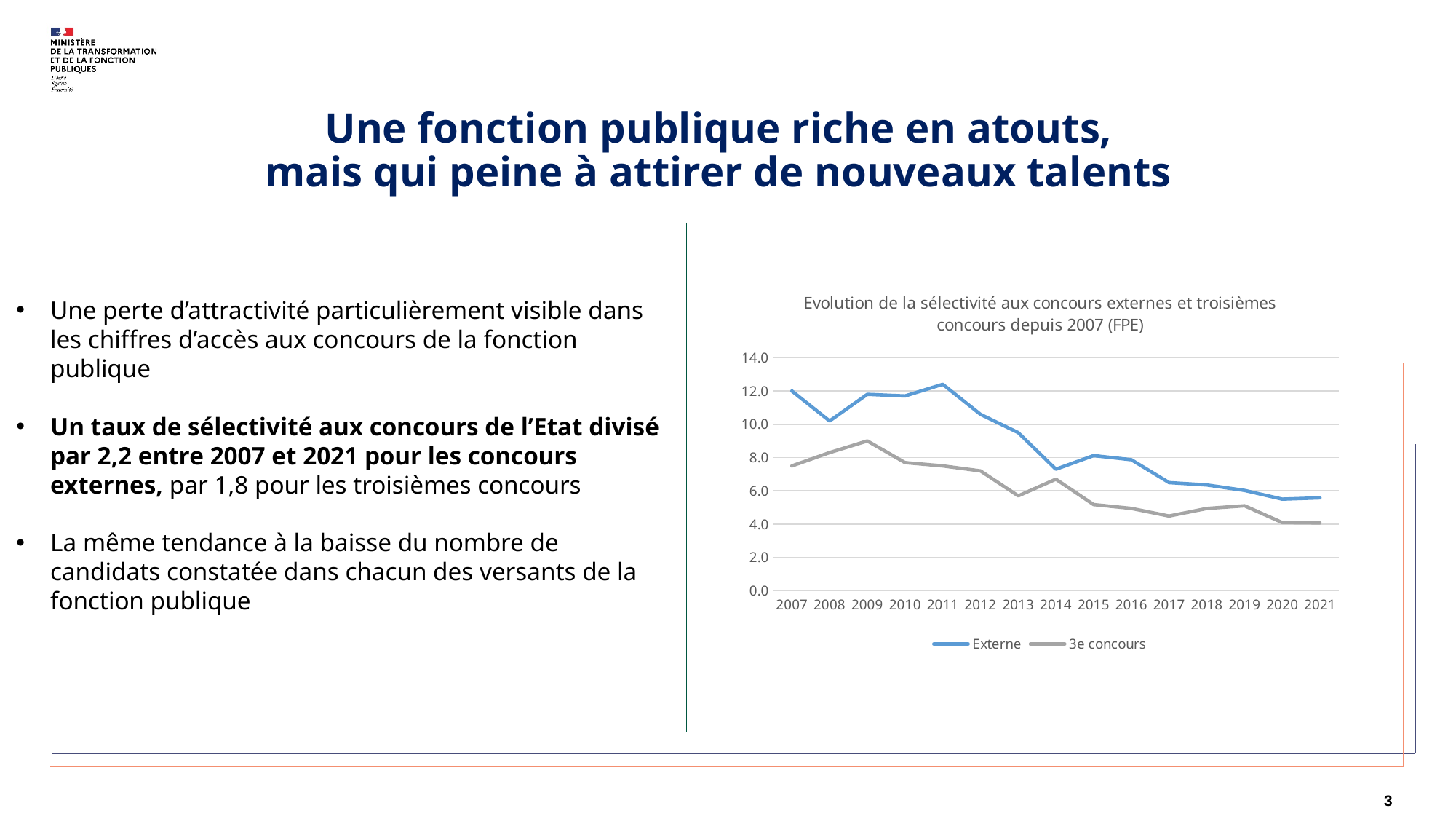
How many years are plotted along the x axis of the chart? 15 Is the value for Externe in 2021 greater or less than 8.0? less Is the value for 3e concours in 2009 greater or less than 8.0? greater What kind of chart is shown on the slide? Line chart In which year does the 3e concours series reach its highest value? 2009 Is the value for 3e concours in 2021 greater or less than 6.0? less Overall, do the values of the Externe series rise or fall from 2007 to 2021? Fall Which series is drawn in grey in the chart? 3e concours How many series does the chart legend list? 2 In 2011, which series has the larger value, Externe or 3e concours? Externe In which year does the Externe series reach its highest value? 2011